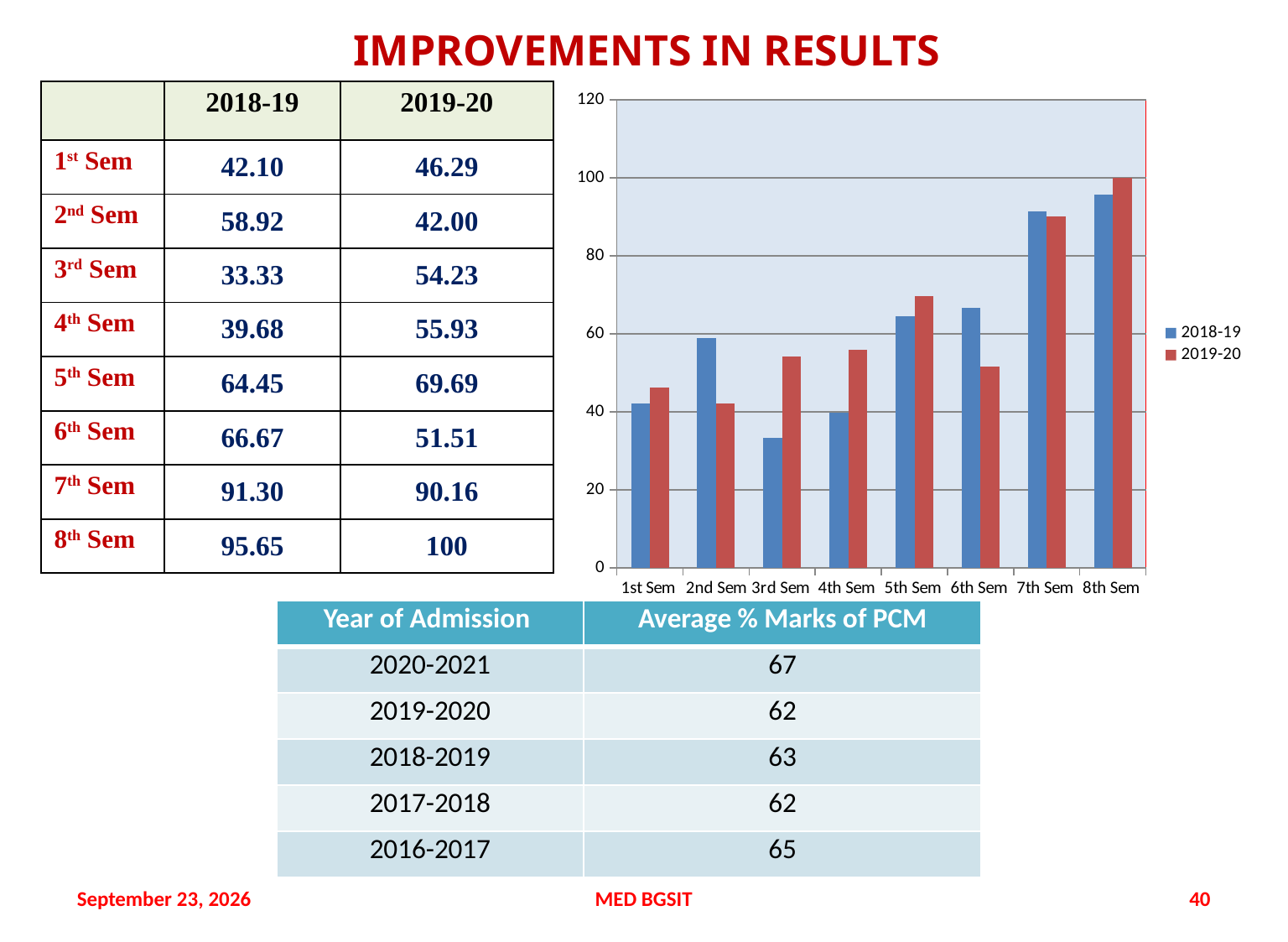
How many semester categories are shown on the x axis of the chart? 8 Is the value for 3rd Sem in the 2018-19 series greater or less than 40? less What is the value for 1st Sem in the 2018-19 series? 42.10 Is the value for 7th Sem in the 2018-19 series greater or less than 80? greater For 6th Sem, which series has the larger value, 2018-19 or 2019-20? 2018-19 How many series does the chart legend list? 2 Which semester has the highest value in the 2018-19 series? 8th Sem What kind of chart is shown on the slide? bar chart What is the difference between the 2019-20 and 2018-19 values for 4th Sem? 16.25 Which semester has the lowest value in the 2018-19 series? 3rd Sem Which semester has the lowest value in the 2019-20 series? 2nd Sem What is the value for 8th Sem in the 2019-20 series? 100